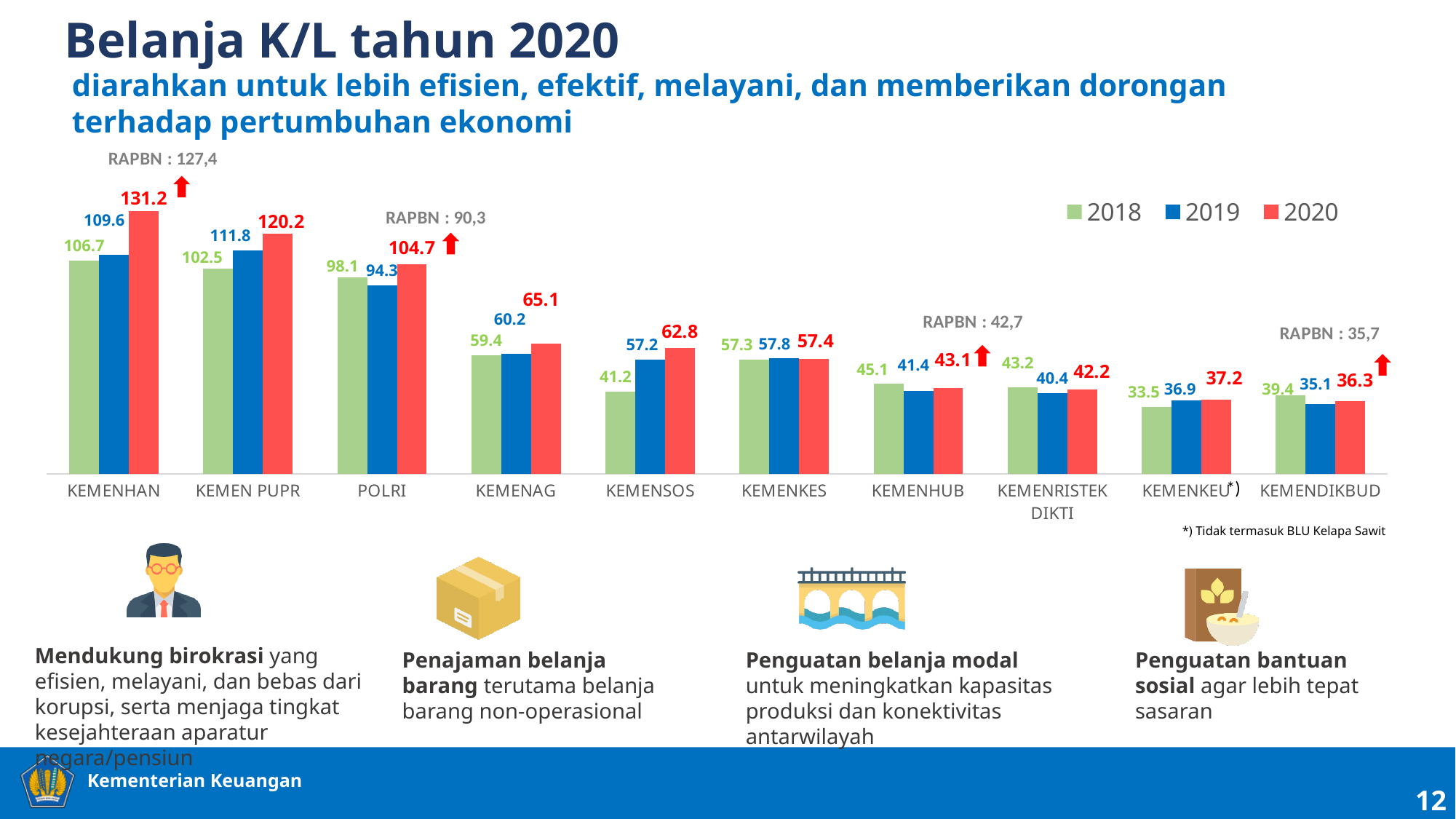
How many series does the legend list? 3 Which category has the highest 2020 value? KEMENHAN Which is larger for KEMENHUB, the 2018 value or the 2020 value? 2018 How many categories are shown on the x axis? 10 What is the difference between the 2020 values for KEMEN PUPR and POLRI? 15.5 What is the 2019 value for POLRI? 94.3 Which category has the lowest 2018 value? KEMENKEU What is the 2020 value for KEMENHAN? 131.2 What kind of chart is shown on the slide? Bar chart What is the difference between the 2020 and 2019 values for KEMENHAN? 21.6 What is the 2020 value for KEMENRISTEK DIKTI? 42.2 What is the 2018 value for KEMENSOS? 41.2